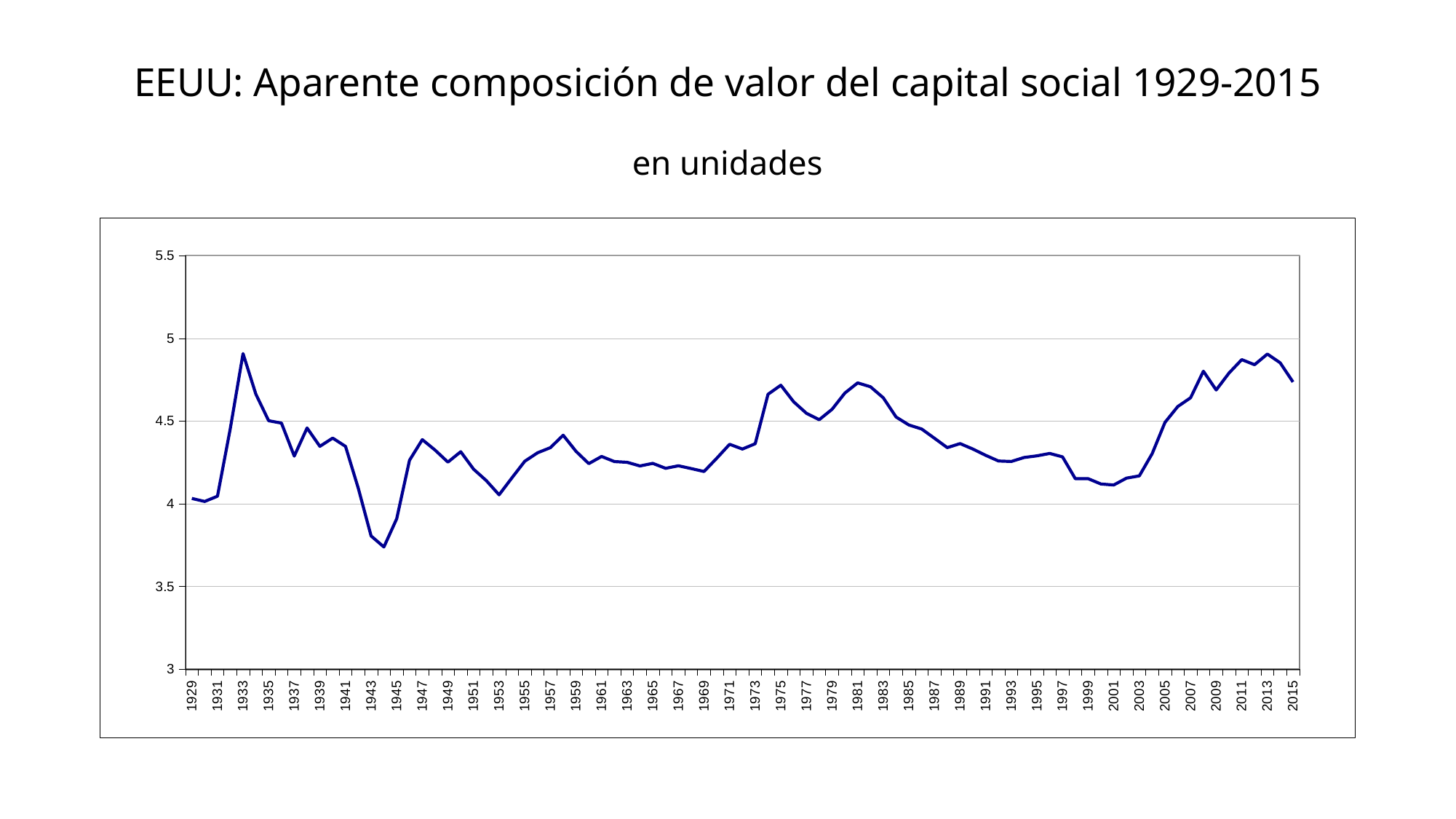
What is the title of the chart on the slide? EEUU: Aparente composición de valor del capital social 1929-2015 Is the value for 1975 greater or less than 4.5? greater Which year has the lowest value on the chart? 1944 Which is larger, the value for 2013 or the value for 2003? 2013 What kind of chart is shown on the slide? line chart Is the value for 2007 greater or less than 4.5? greater Do the values rise or fall from 2001 to 2007? rise Is the value for 1944 greater or less than 4? less Which is larger, the value for 1933 or the value for 1944? 1933 Do the values rise or fall from 1933 to 1944? fall